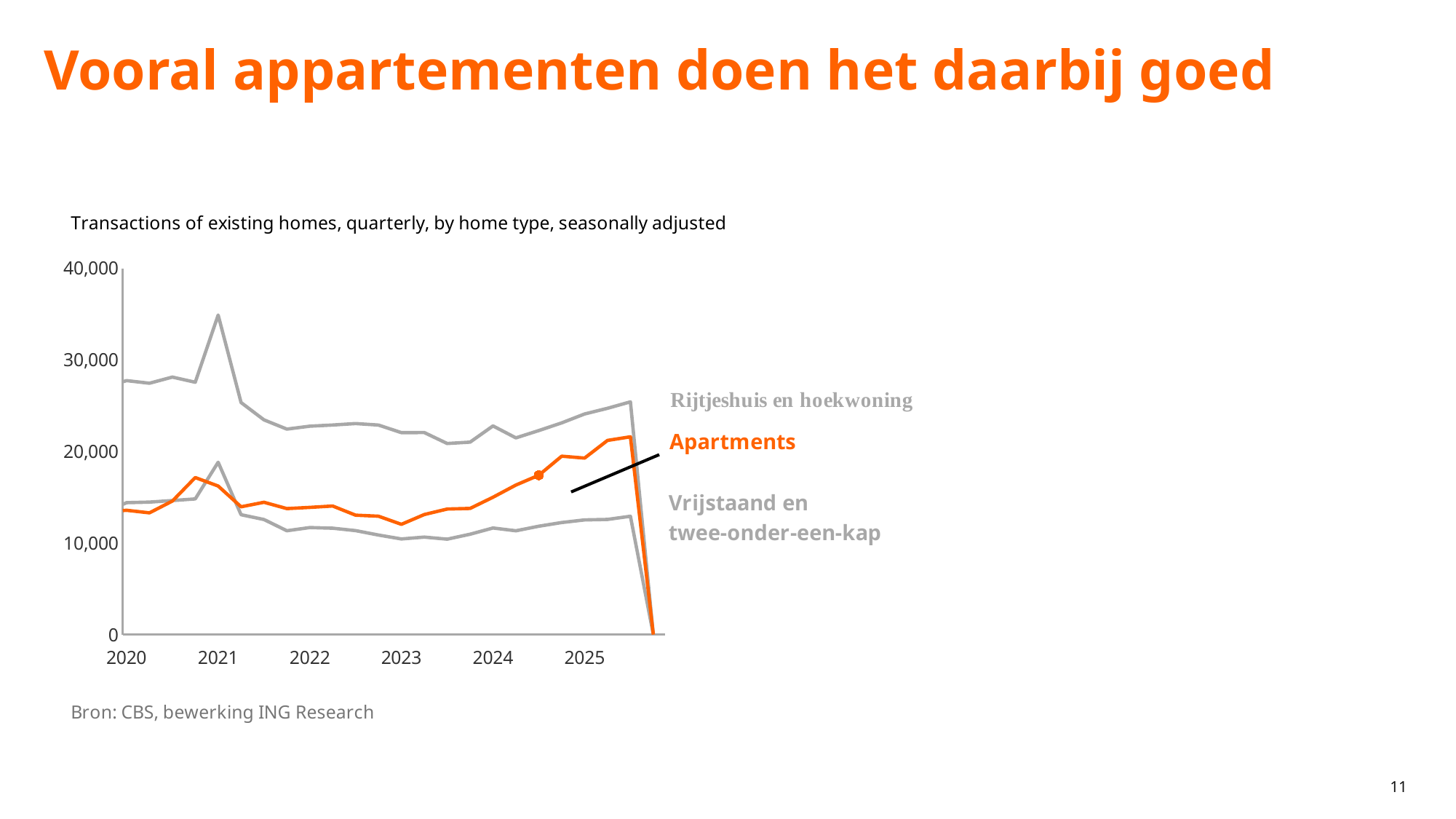
What kind of chart is shown on the slide? Line chart Is the value for Rijtjeshuis en hoekwoning at the start of 2020 greater or less than 20,000? greater Is the peak value of Rijtjeshuis en hoekwoning around 2021 greater or less than 30,000? greater Is the value for Apartments at the start of 2020 greater or less than 20,000? less How many series are plotted in the chart? 3 What colour is the Apartments line? Orange What is the subtitle describing the chart's data? Transactions of existing homes, quarterly, by home type, seasonally adjusted Which series has the highest values throughout the chart? Rijtjeshuis en hoekwoning At the start of 2025, which is larger: Apartments or Vrijstaand en twee-onder-een-kap? Apartments Do the values for Apartments rise or fall between 2023 and 2025? rise